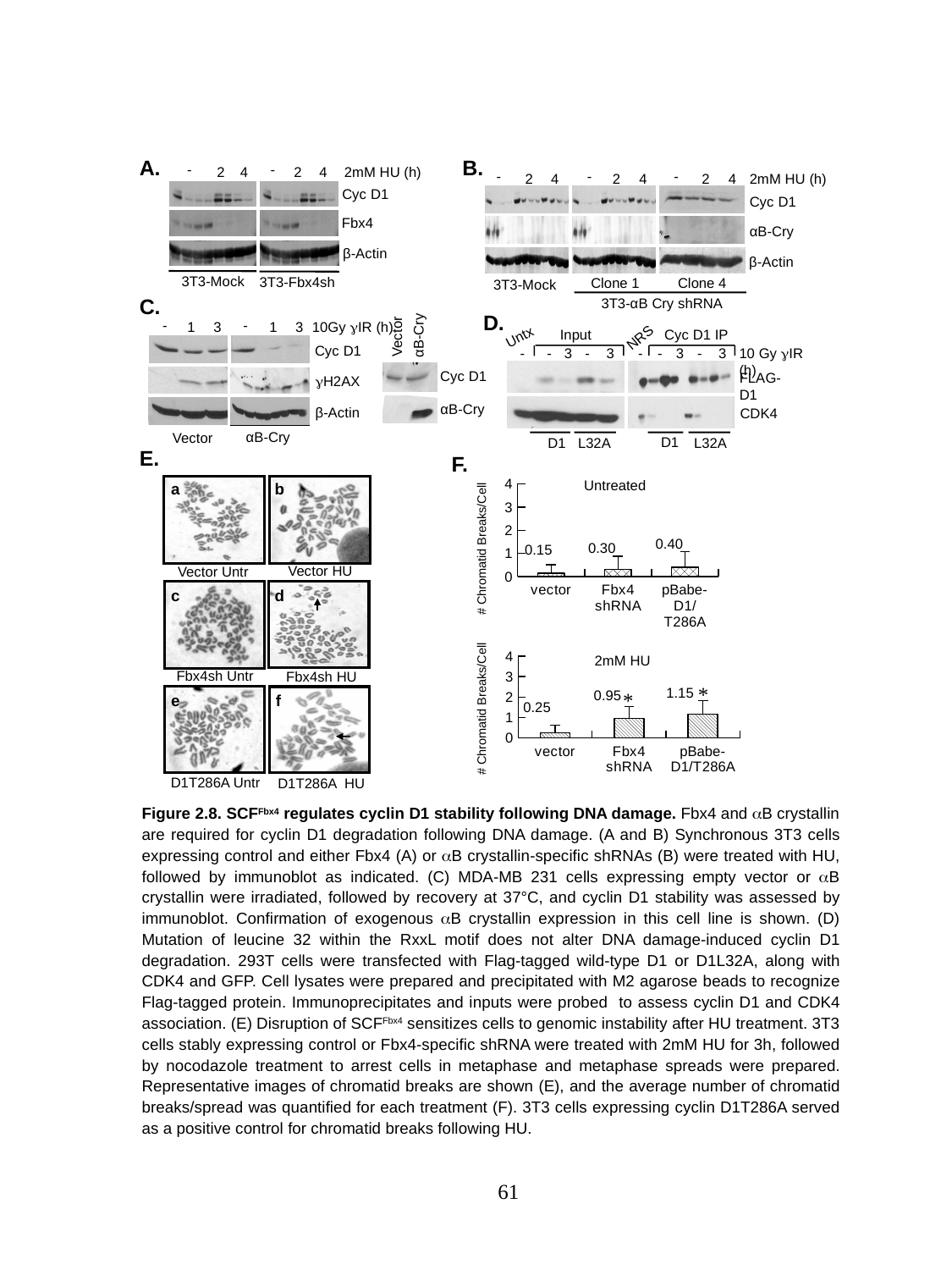
In the Untreated chart in panel F, what is the difference between the values for pBabe-D1/T286A and vector? 0.25 In the 2mM HU chart in panel F, which category has the highest number of chromatid breaks per cell? pBabe-D1/T286A In the Untreated chart in panel F, what is the number of chromatid breaks per cell for vector? 0.15 In the 2mM HU chart in panel F, is the value for pBabe-D1/T286A greater or less than 1? greater In panel F, is the value for Fbx4 shRNA larger in the Untreated chart or the 2mM HU chart? 2mM HU In the Untreated chart in panel F, which category has the lowest number of chromatid breaks per cell? vector In the Untreated chart in panel F, what is the value for Fbx4 shRNA? 0.30 In the 2mM HU chart in panel F, what is the value for pBabe-D1/T286A? 1.15 In the 2mM HU chart in panel F, what is the value for Fbx4 shRNA? 0.95 How many categories are shown on the x axis of the Untreated chart in panel F? 3 In the 2mM HU chart in panel F, what is the difference between the values for Fbx4 shRNA and vector? 0.70 What kind of chart is used in panel F? bar chart